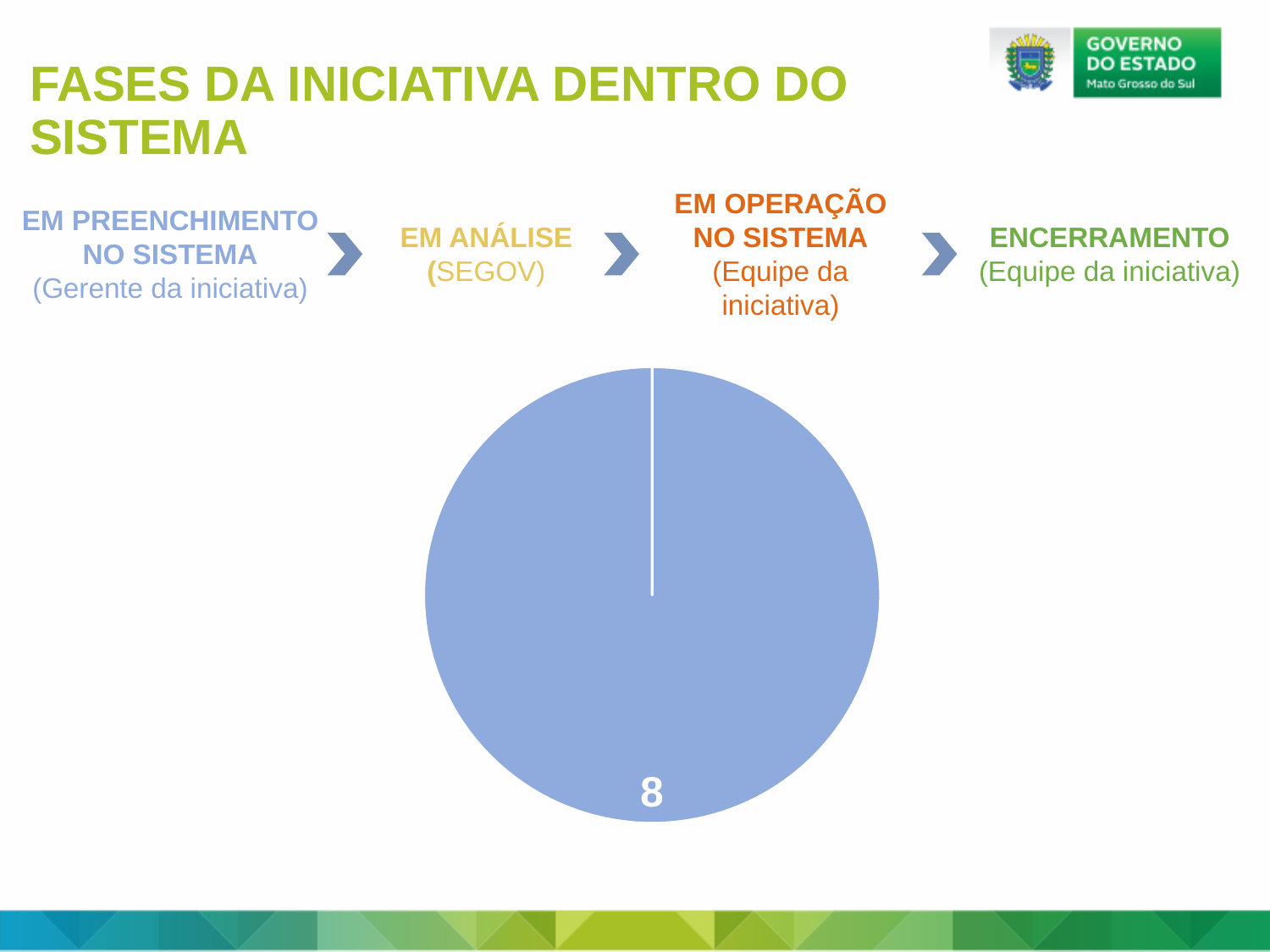
What share of the pie does the single slice labelled 8 represent? 100% What colour is the slice of the pie chart? blue What value is printed as the data label on the pie chart? 8 What kind of chart is shown on the slide? pie chart How many data labels are printed on the pie chart? 1 How many slices does the pie chart show? 1 Does the pie chart display a legend? No Is the value printed on the pie chart greater or less than 5? greater